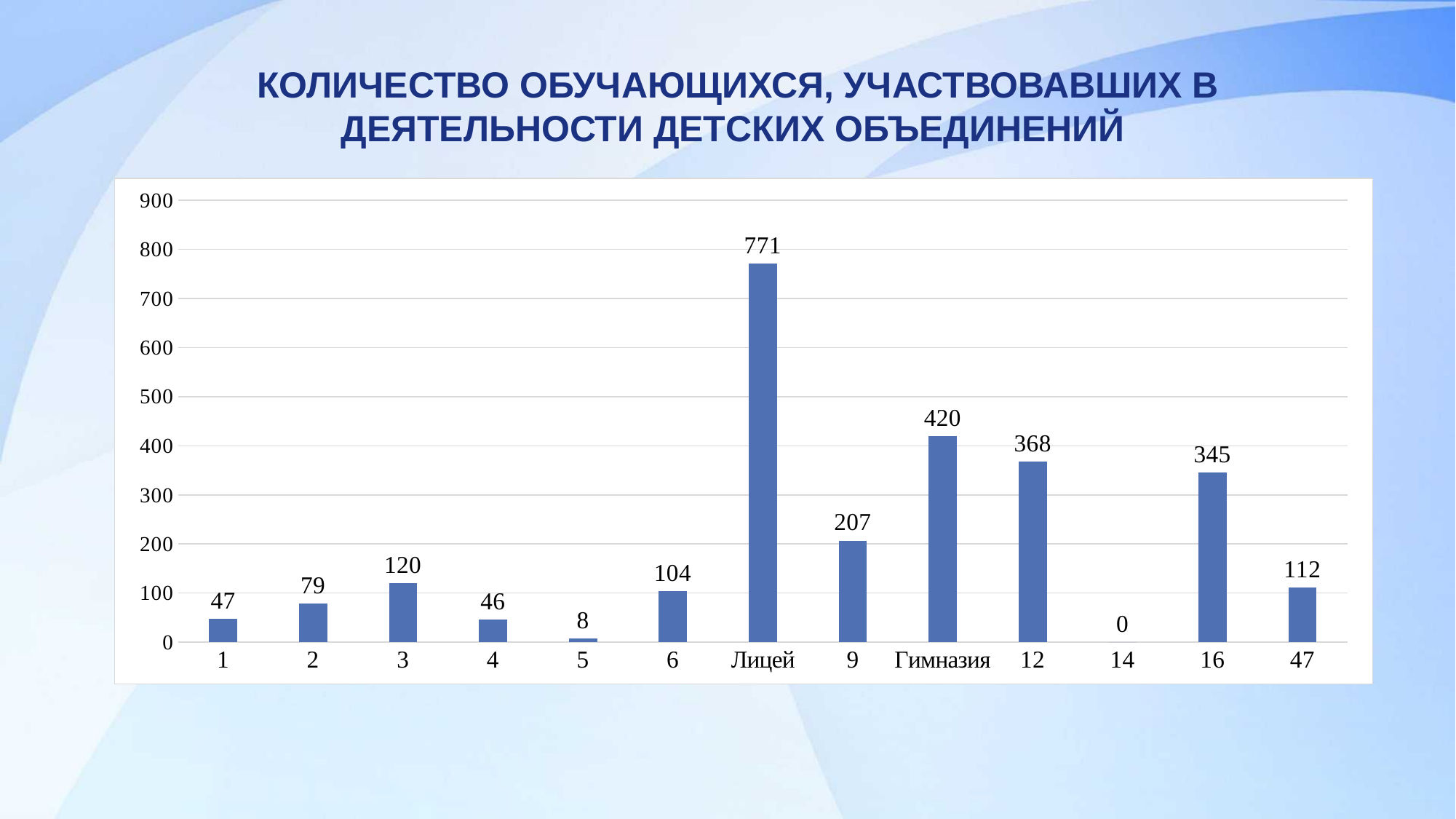
What is the value for Лицей? 771 How many categories are shown on the x axis? 13 What is the difference between the values for category 3 and category 2? 41 What is the value for category 14? 0 Which is larger, the value for category 12 or the value for category 16? 12 Is the value for category 9 greater or less than 200? greater What is the value for Гимназия? 420 Which category has the lowest value? 14 What kind of chart is shown on the slide? bar chart What is the difference between the values for Лицей and Гимназия? 351 What is the value for category 16? 345 Which category has the highest value? Лицей